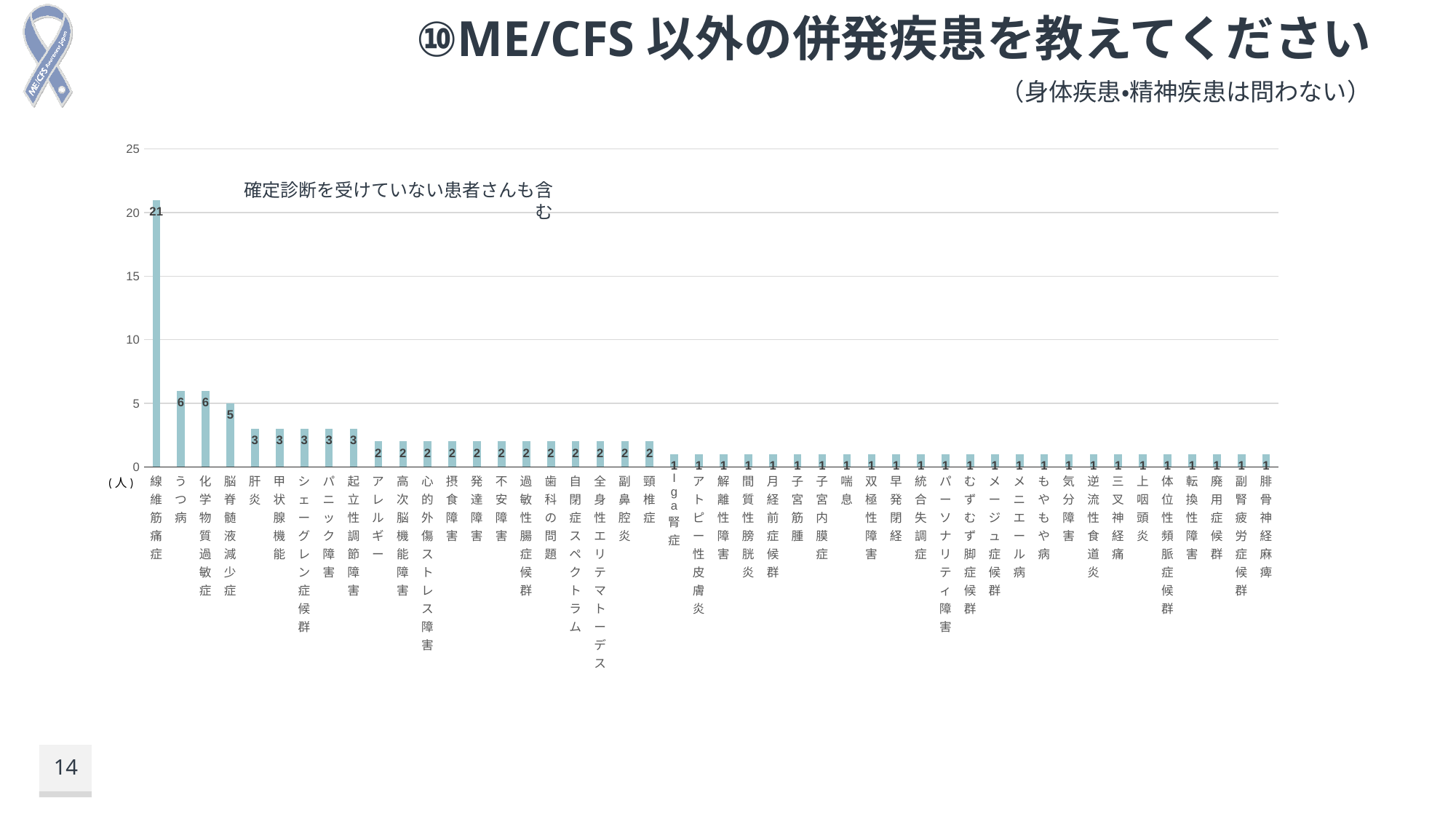
Which is larger, the value for 脳脊髄液減少症 or the value for 肝炎? 脳脊髄液減少症 Is the value for 線維筋痛症 greater or less than 20? greater Is the value for 化学物質過敏症 greater or less than 10? less What is the value for 脳脊髄液減少症? 5 What unit is shown at the bottom of the vertical axis? (人) What is the difference between the values for 線維筋痛症 and うつ病? 15 What kind of chart is shown on the slide? bar chart What is the value for 過敏性腸症候群? 2 What is the value for 線維筋痛症? 21 Which category has the highest value? 線維筋痛症 What is the value for 起立性調節障害? 3 Do the values rise or fall from left to right along the x axis? fall